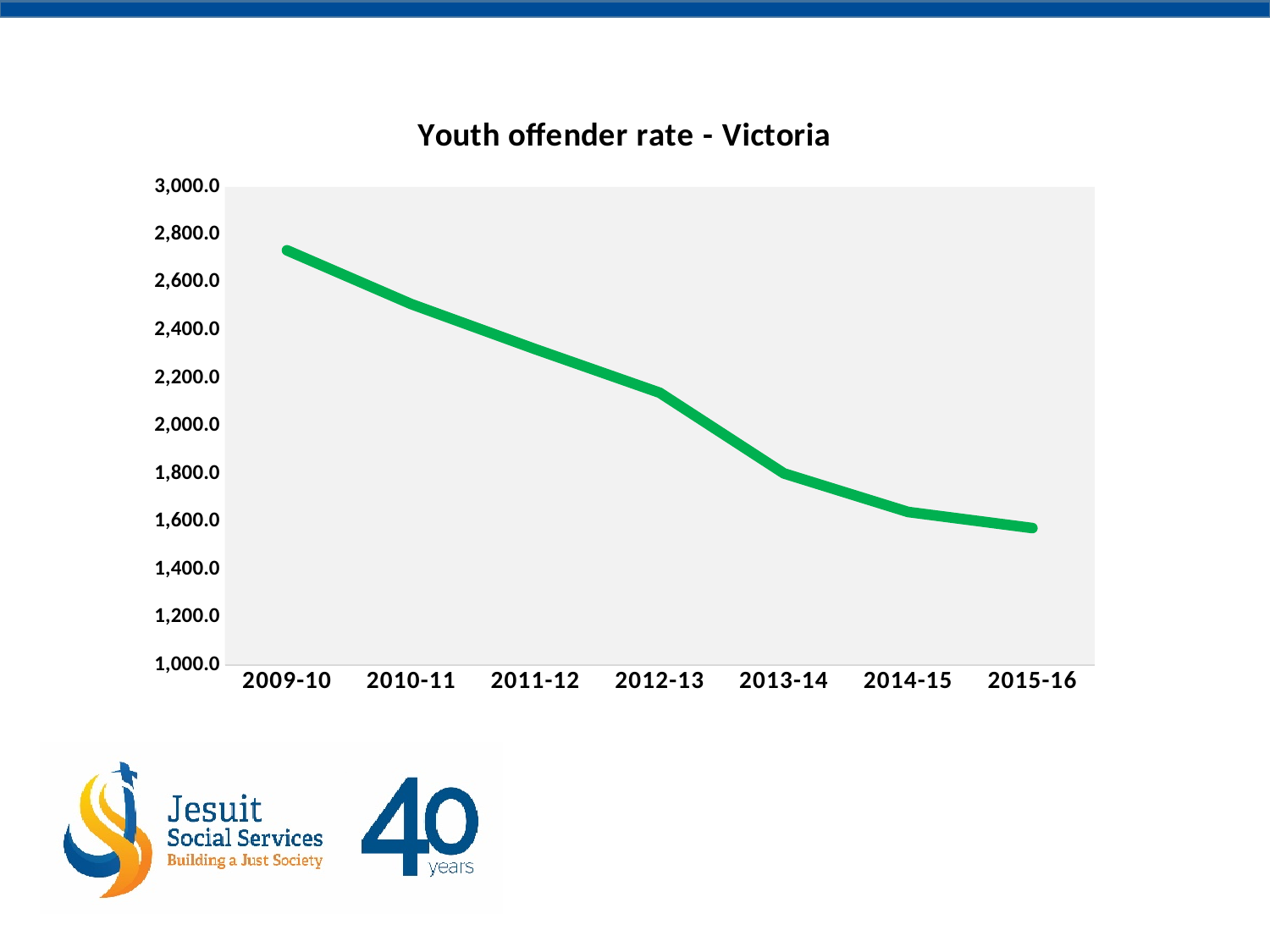
Is the value for 2013-14 greater or less than 2,000.0? less What colour is the plotted line? green Is the value for 2012-13 greater or less than 2,000.0? greater What kind of chart is shown on the slide? line chart Which year has the highest youth offender rate? 2009-10 Which year has the lowest youth offender rate? 2015-16 Is the value for 2015-16 greater or less than 1,800.0? less Do the values rise or fall from 2009-10 to 2015-16? fall What is the title of the chart? Youth offender rate - Victoria Which is larger, the value for 2009-10 or the value for 2013-14? 2009-10 How many years are plotted along the x axis? 7